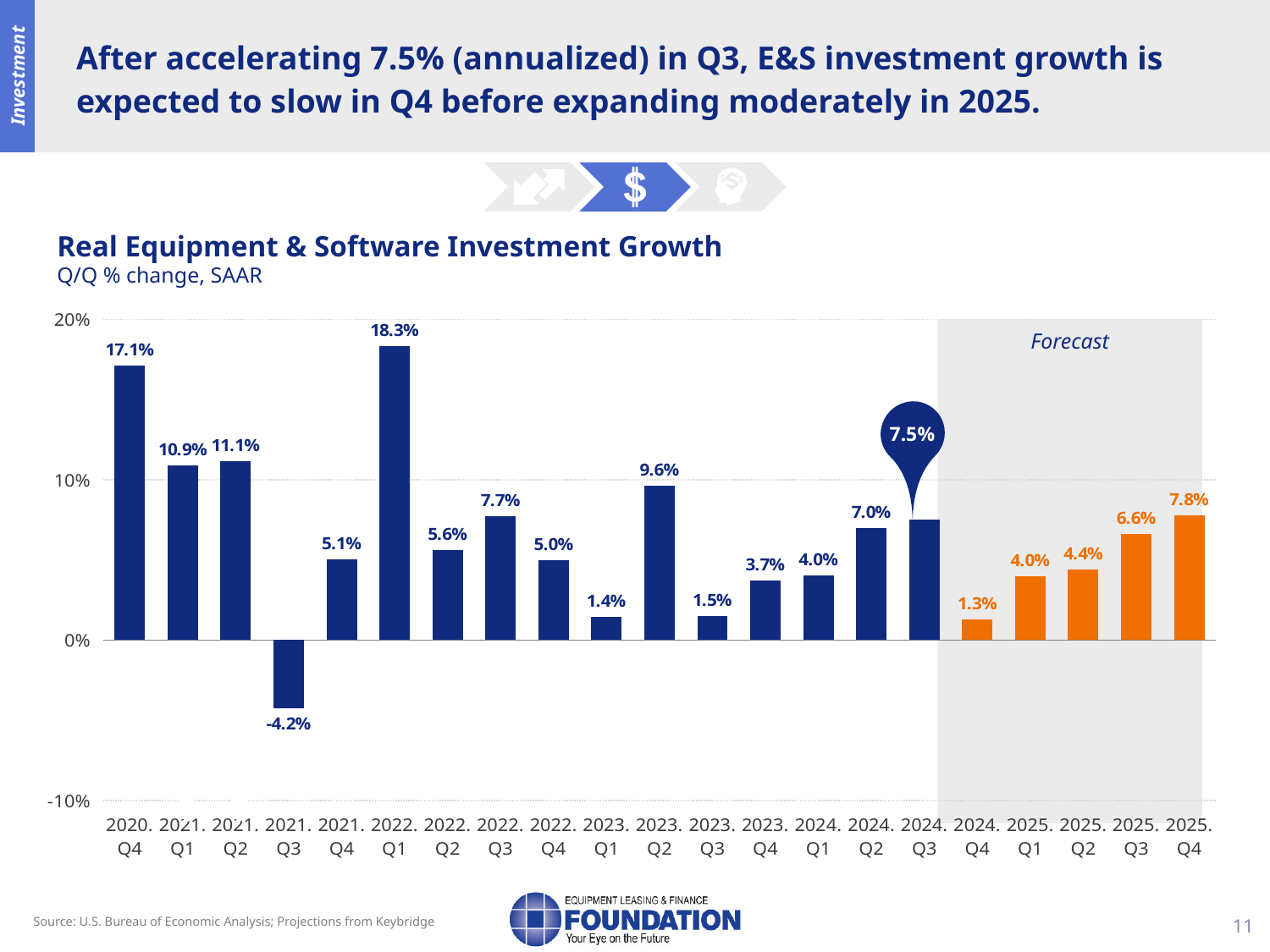
Which is larger, the value for 2023 Q2 or the value for 2022 Q3? 2023 Q2 What is the difference between the values for 2024 Q3 and 2024 Q4? 6.2% Is the value for 2020 Q4 greater or less than 10%? greater How many quarters are shown on the x axis? 21 What kind of chart is this? Bar chart Which quarter has the highest value? 2022 Q1 What is the value for 2024 Q3? 7.5% Which quarter has the lowest value? 2021 Q3 Do the forecast values rise or fall from 2024 Q4 to 2025 Q4? Rise What is the value for 2022 Q1? 18.3% What is the forecast value for 2025 Q4? 7.8% What is the subtitle shown under the chart title? Q/Q % change, SAAR